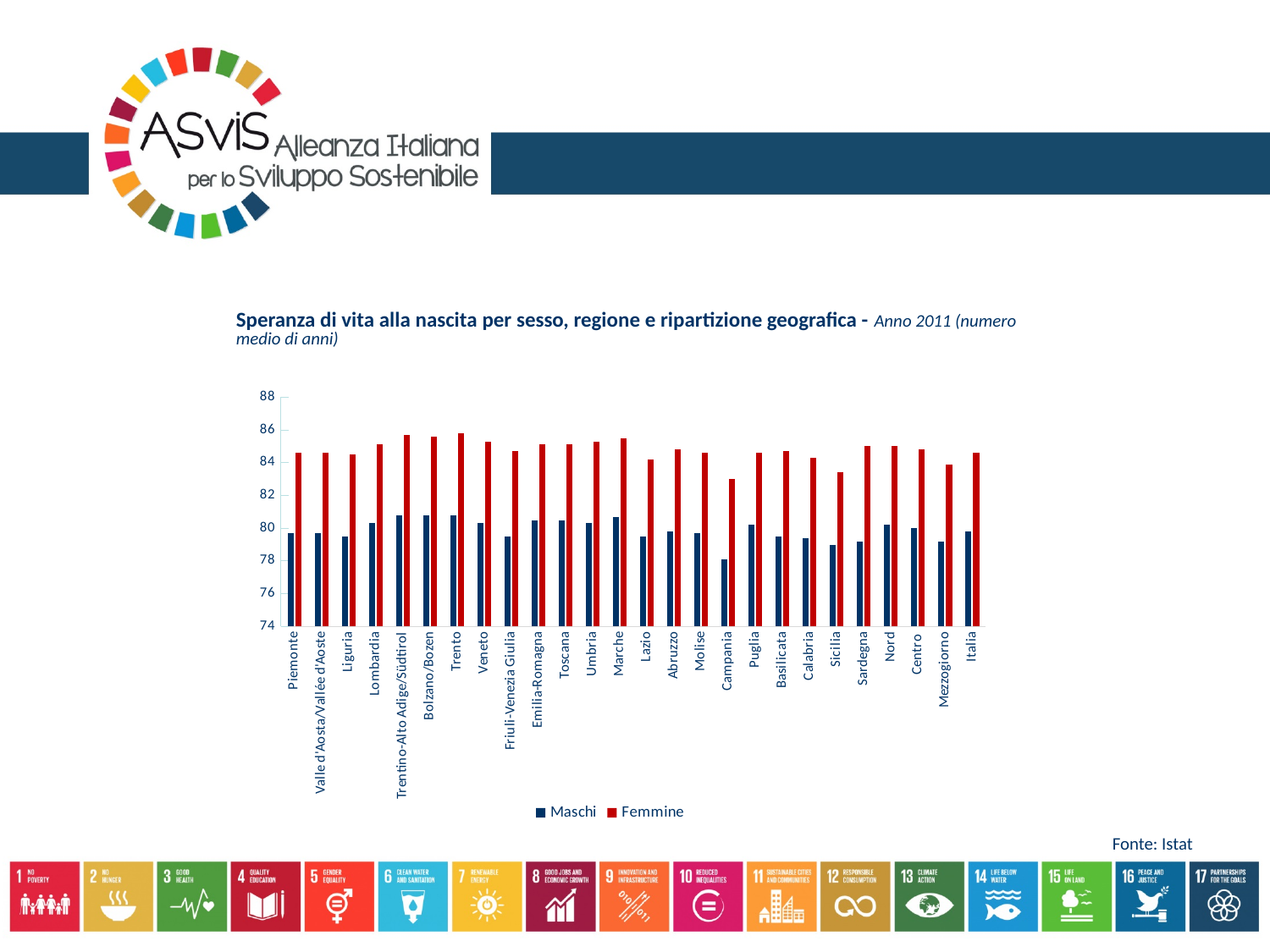
Which category has the lowest value for Maschi? Campania Which category has the lowest value for Femmine? Campania Which is larger, the Maschi value for Trento or the Maschi value for Campania? Trento Is the Maschi value for Sicilia greater or less than 80? less How many series does the legend list? 2 Is the Femmine value for Trento greater or less than 84? greater For Italia, which series has the larger value, Maschi or Femmine? Femmine How many categories (regions and geographic areas) are shown on the x axis? 26 What kind of chart is shown on the slide? bar chart Is the Maschi value for Campania greater or less than 80? less What are the two series named in the legend? Maschi and Femmine